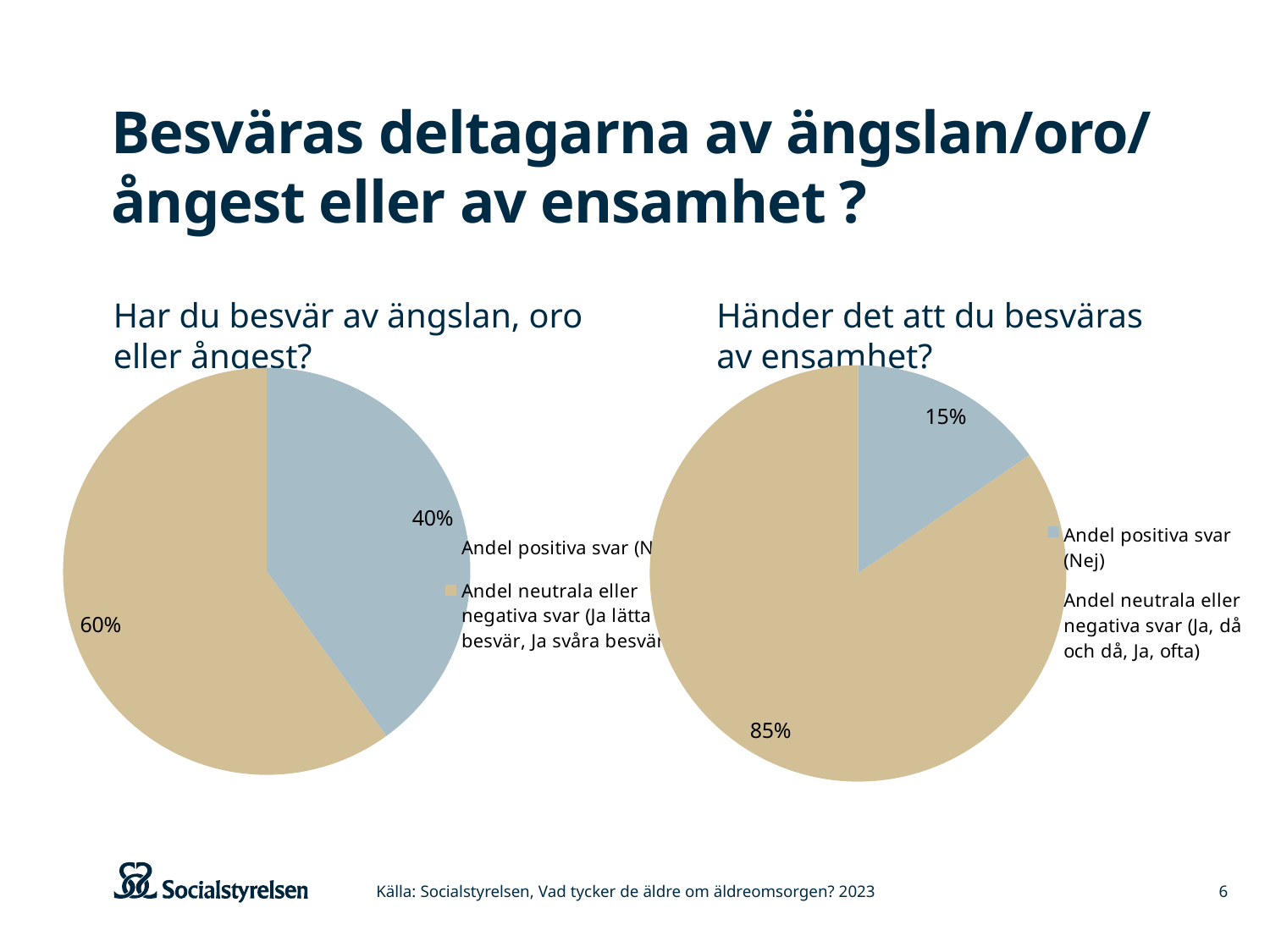
In the left pie chart ('Har du besvär av ängslan, oro eller ångest?'), what share is labelled for the 'Andel neutrala eller negativa svar' slice? 60% In the left pie chart ('Har du besvär av ängslan, oro eller ångest?'), what is the difference in percentage points between the 60% slice and the 40% slice? 20 percentage points In the left pie chart ('Har du besvär av ängslan, oro eller ångest?'), what share is labelled for the 'Andel positiva svar' slice? 40% In the left pie chart ('Har du besvär av ängslan, oro eller ångest?'), which slice is the largest? Andel neutrala eller negativa svar How many pie charts are shown on the slide? 2 In the right pie chart ('Händer det att du besväras av ensamhet?'), what share is labelled for 'Andel neutrala eller negativa svar'? 85% How many slices does the right pie chart ('Händer det att du besväras av ensamhet?') have? 2 What kind of chart is used on the slide for 'Har du besvär av ängslan, oro eller ångest?' Pie chart In the right pie chart ('Händer det att du besväras av ensamhet?'), what is the difference in percentage points between the 85% slice and the 15% slice? 70 percentage points In the right pie chart ('Händer det att du besväras av ensamhet?'), what share is labelled for 'Andel positiva svar (Nej)'? 15% In the right pie chart ('Händer det att du besväras av ensamhet?'), which slice is the smallest? Andel positiva svar (Nej) Which is larger: the 'Andel positiva svar' share in the left pie chart (ängslan, oro eller ångest) or in the right pie chart (ensamhet)? The left pie chart (40%)